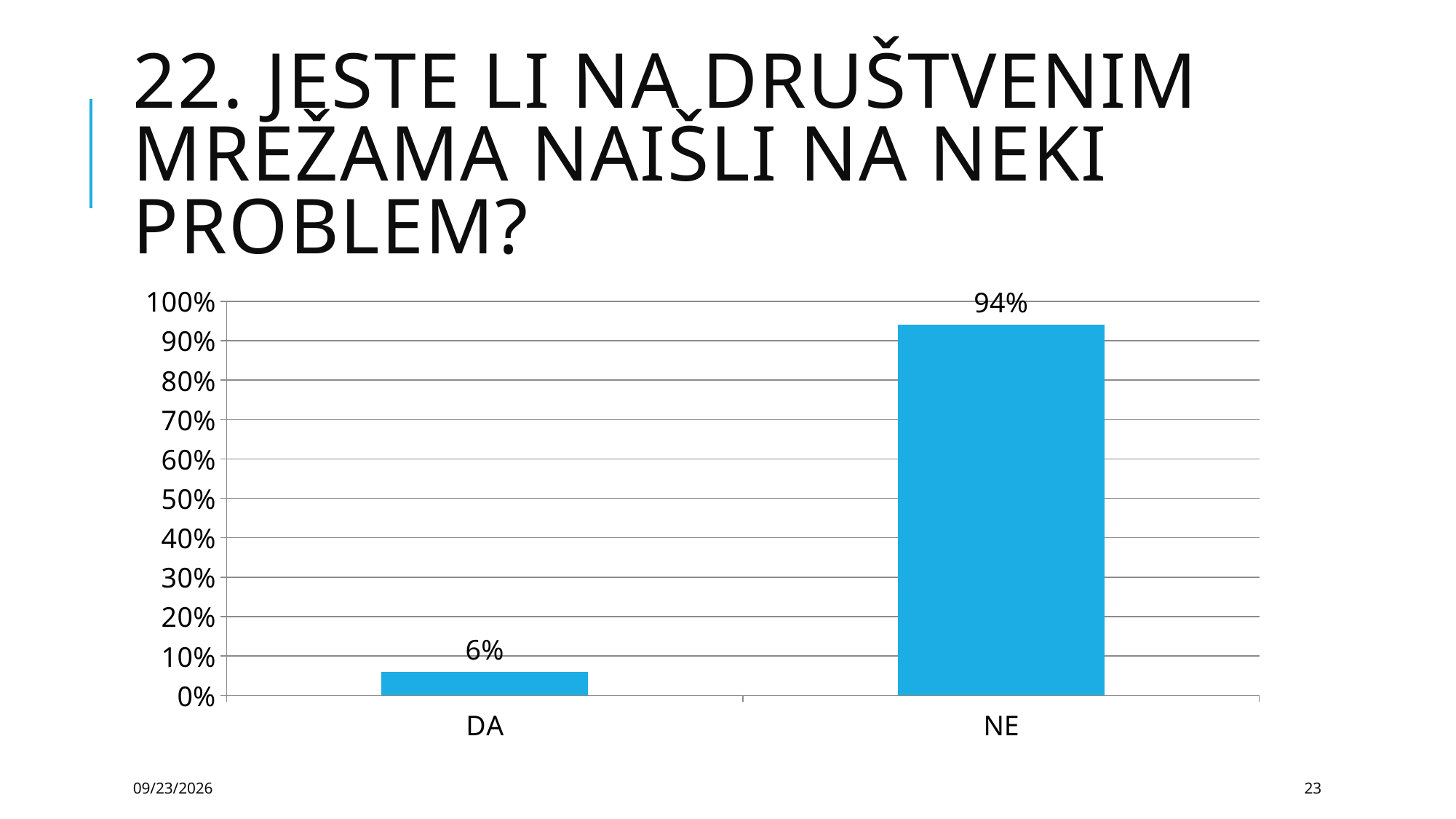
Is the value for NE greater or less than 90%? greater What is the value for DA? 6% How many categories are shown on the x axis? 2 What kind of chart is shown on the slide? bar chart What is the difference between the values for NE and DA? 88% Which is larger, the value for DA or the value for NE? NE Which category has the lowest value? DA What colour are the bars in the chart? blue What is the value for NE? 94% What is the highest value shown on the y axis? 100% Is the value for DA greater or less than 10%? less Which category has the highest value? NE